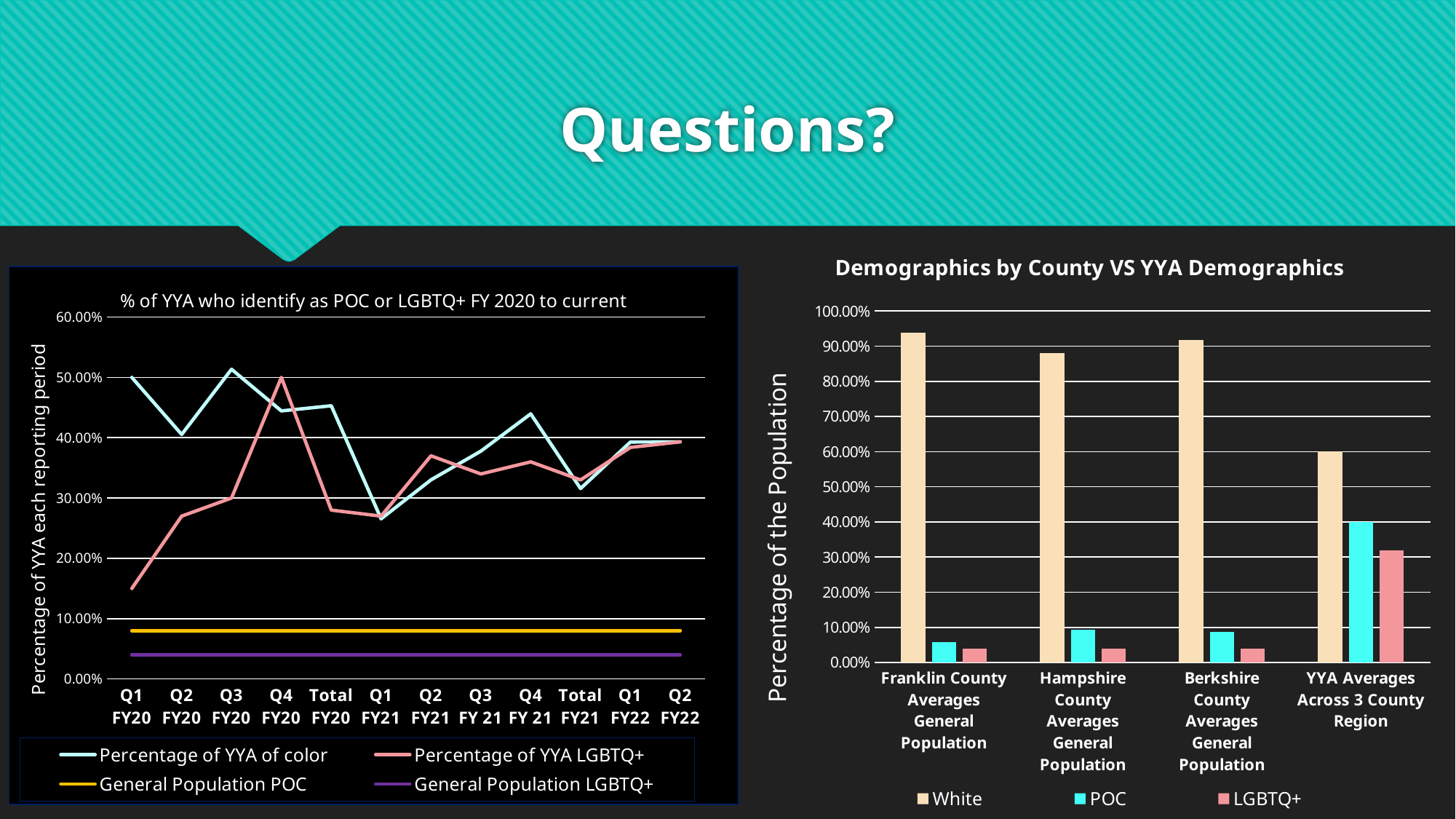
In the left line chart, how many series does the legend list? 4 In the left line chart, which series is higher at Q1 FY20: Percentage of YYA of color or Percentage of YYA LGBTQ+? Percentage of YYA of color In the right bar chart, which category has the lowest White value? YYA Averages Across 3 County Region In the right bar chart, how many categories are shown on the x axis? 4 In the left line chart, is the Percentage of YYA LGBTQ+ at Q1 FY20 greater or less than 20.00%? less In the right bar chart, is the White value for Franklin County Averages General Population greater or less than 90.00%? greater What kind of chart is the chart on the left titled '% of YYA who identify as POC or LGBTQ+ FY 2020 to current'? line chart In the right bar chart 'Demographics by County VS YYA Demographics', how many series does the legend list? 3 What kind of chart is 'Demographics by County VS YYA Demographics' on the right? bar chart In the right bar chart, is the POC value for Franklin County Averages General Population greater or less than 10.00%? less In the right bar chart, which category has the highest POC value? YYA Averages Across 3 County Region In the left line chart, how many reporting periods are shown on the x axis? 12